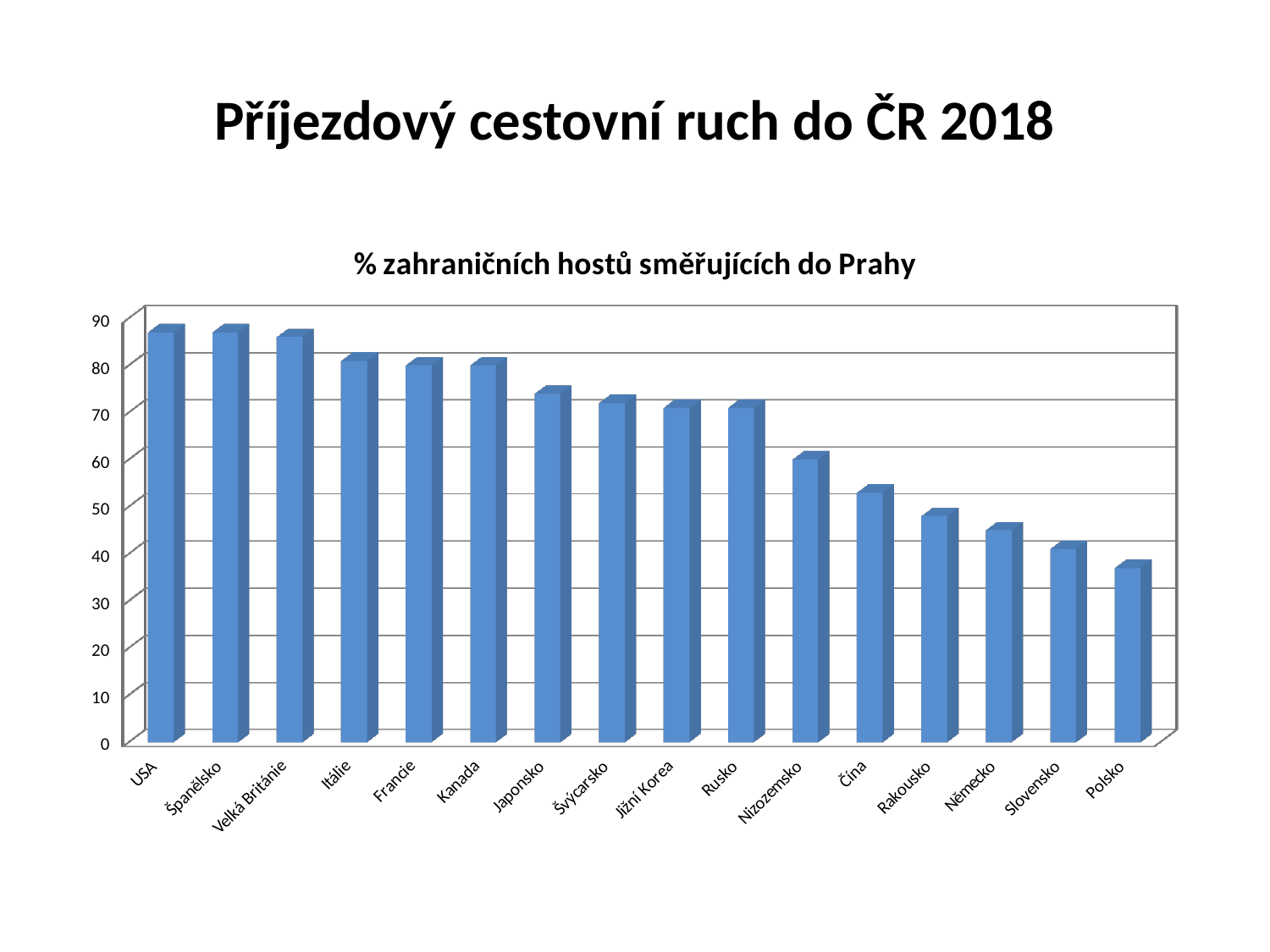
How many countries are shown on the x axis of the chart? 16 Is the value for Japonsko greater or less than 70? greater Which has the larger value, Rakousko or Velká Británie? Velká Británie What is the title of the chart? % zahraničních hostů směřujících do Prahy What kind of chart is shown on the slide? bar chart Is the value for USA greater or less than 80? greater Do the values rise or fall moving from left to right along the x axis? fall Is the value for Německo greater or less than 50? less Which country has the lowest value in the chart? Polsko Which has the larger value, Itálie or Nizozemsko? Itálie